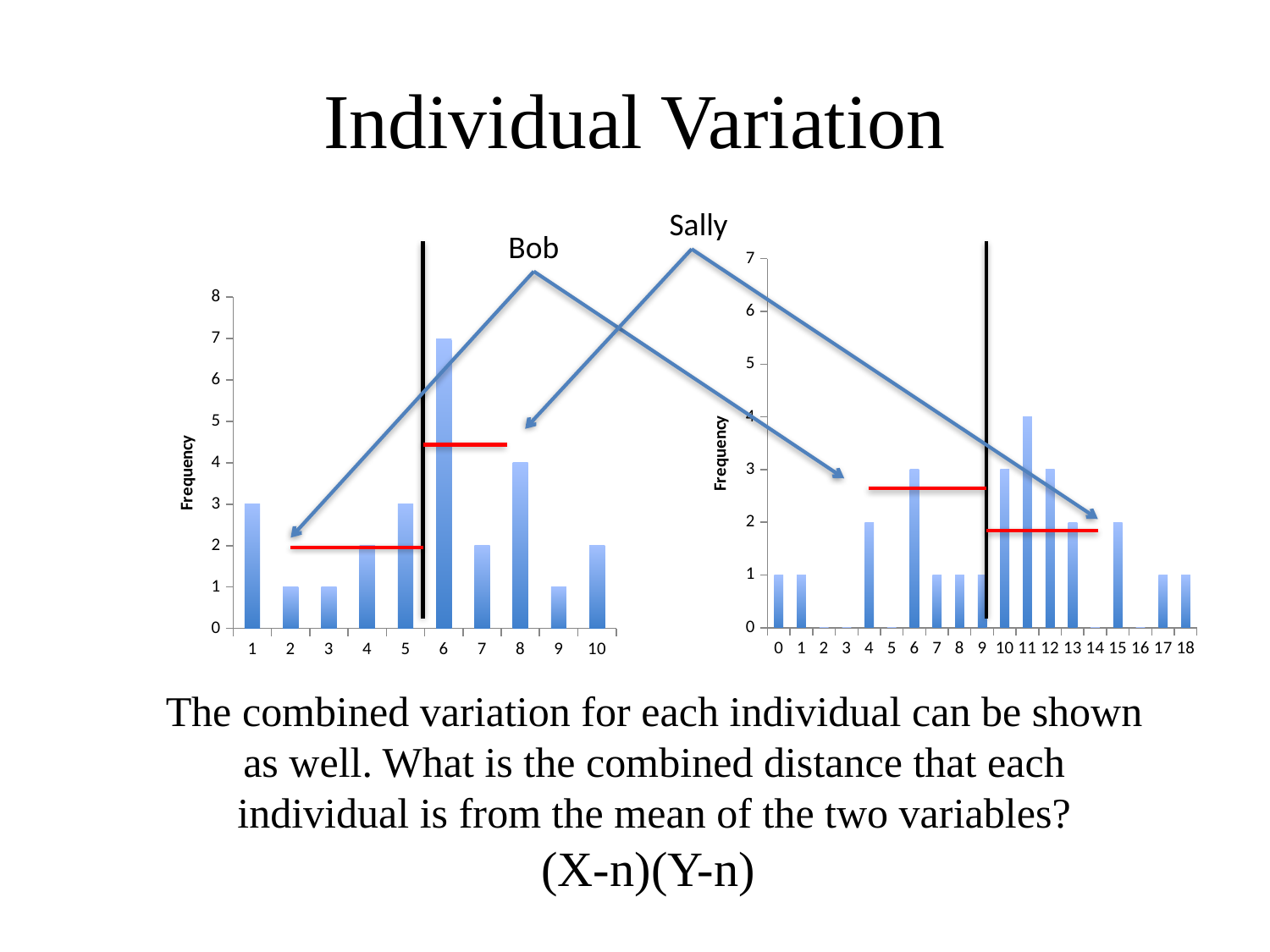
In the left chart, which is larger, the frequency for category 5 or the frequency for category 9? category 5 In the left chart, what is the frequency for category 6? 7 In the left chart, is the frequency for category 6 greater or less than 5? greater What is the y-axis title of the left chart? Frequency In the left chart, how many categories are shown on the x axis? 10 In the left chart, what is the frequency for category 1? 3 In the right chart, how many categories are labelled on the x axis? 19 In the right chart, which x-axis category has the highest frequency? 11 In the right chart, is the frequency for category 6 greater or less than 2? greater In the left chart, which x-axis category has the highest frequency? 6 What kind of chart is the left chart on the slide? bar chart In the right chart, what is the frequency for category 11? 4